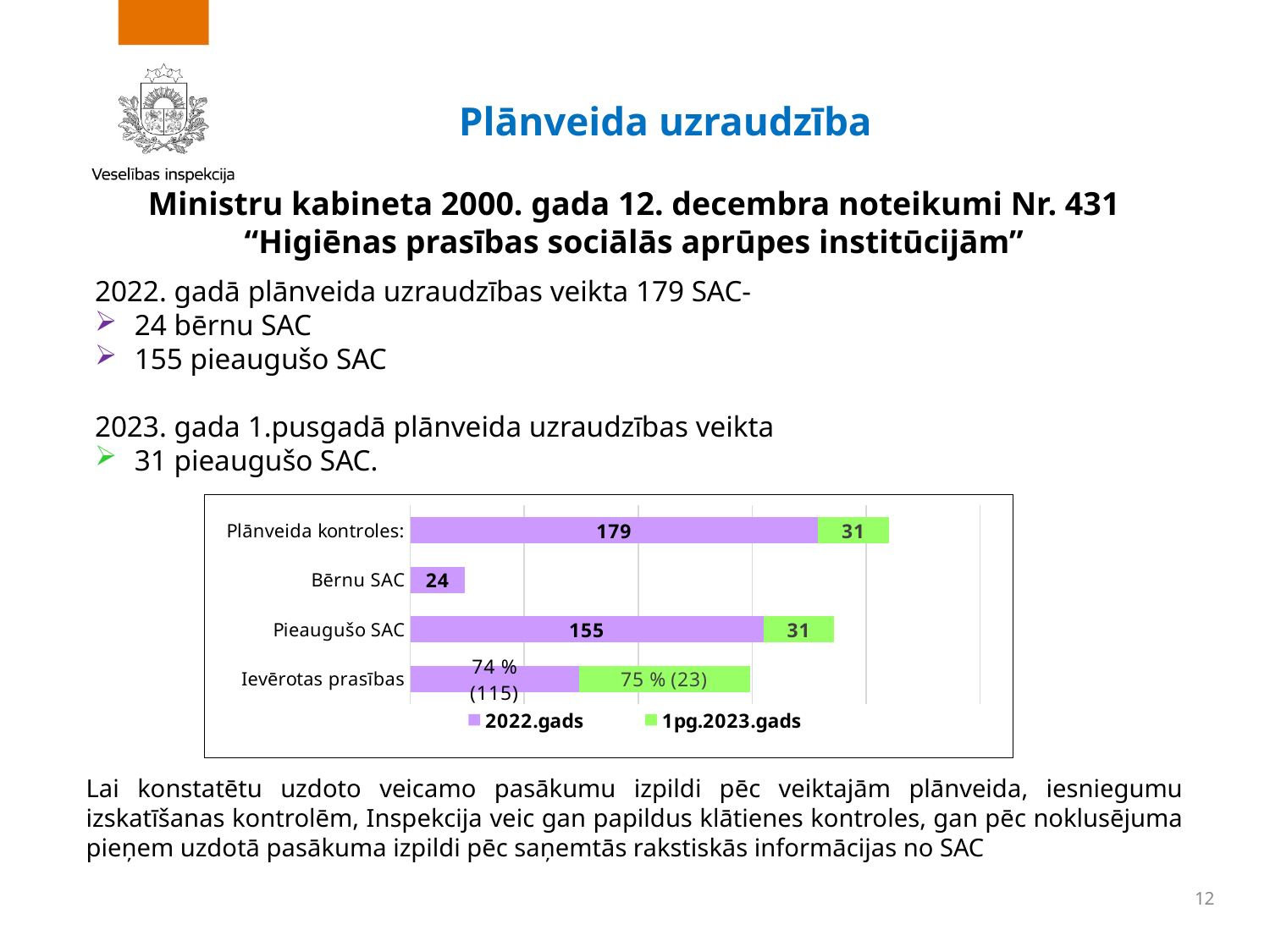
What is the 1pg.2023.gads value for Pieaugušo SAC? 31 Which colour represents the 1pg.2023.gads series in the chart? green Which category has the lowest 2022.gads value? Bērnu SAC How many categories are shown on the chart's vertical axis? 4 Which category has the highest 2022.gads value? Plānveida kontroles What is the 2022.gads value for Plānveida kontroles? 179 What is the 2022.gads value for Bērnu SAC? 24 What is the total of the stacked bar for Pieaugušo SAC? 186 How many series does the chart legend list? 2 What label is shown on the 1pg.2023.gads segment for Ievērotas prasības? 75 % (23) What is the difference between the 2022.gads values for Plānveida kontroles and Pieaugušo SAC? 24 What kind of chart is shown on the slide? bar chart